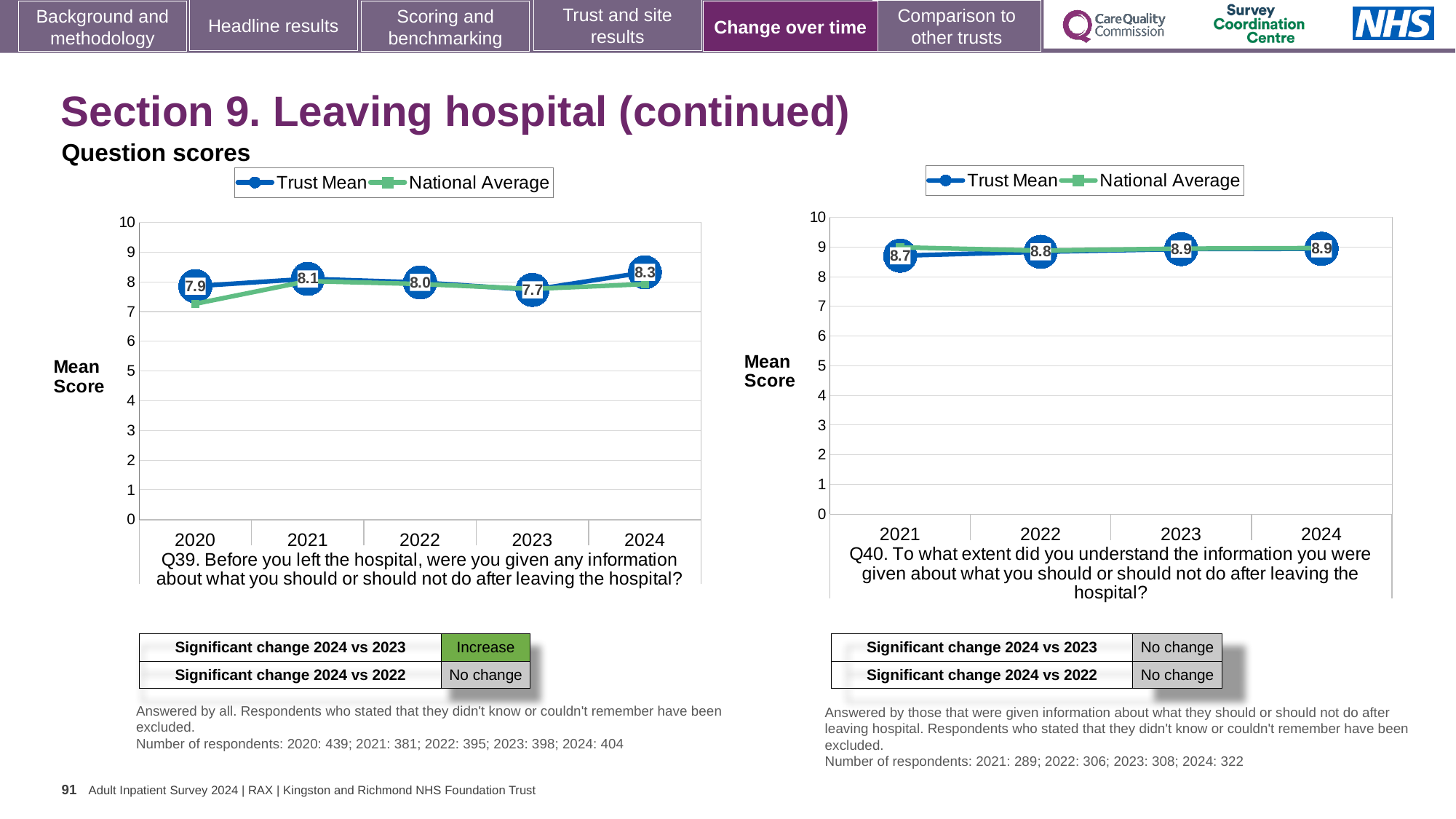
In the Q39 chart, which year has the highest Trust Mean score? 2024 In the Q39 chart, what is the Trust Mean score for 2020? 7.9 How many years are plotted on the x axis of the Q40 chart? 4 In the Q39 chart, which year has the lowest Trust Mean score? 2023 In the Q39 chart, what is the difference between the Trust Mean scores for 2024 and 2023? 0.6 How many series does the legend of the Q39 chart list? 2 In the Q40 chart, what is the difference between the Trust Mean scores for 2024 and 2021? 0.2 In the Q40 chart, what is the Trust Mean score for 2021? 8.7 What kind of chart is used for the Q40 question scores? Line chart In the Q39 chart, is the National Average value for 2020 greater or less than 8? less In the Q39 chart, what is the Trust Mean score for 2024? 8.3 In the Q39 chart, is the Trust Mean score higher in 2021 or in 2022? 2021